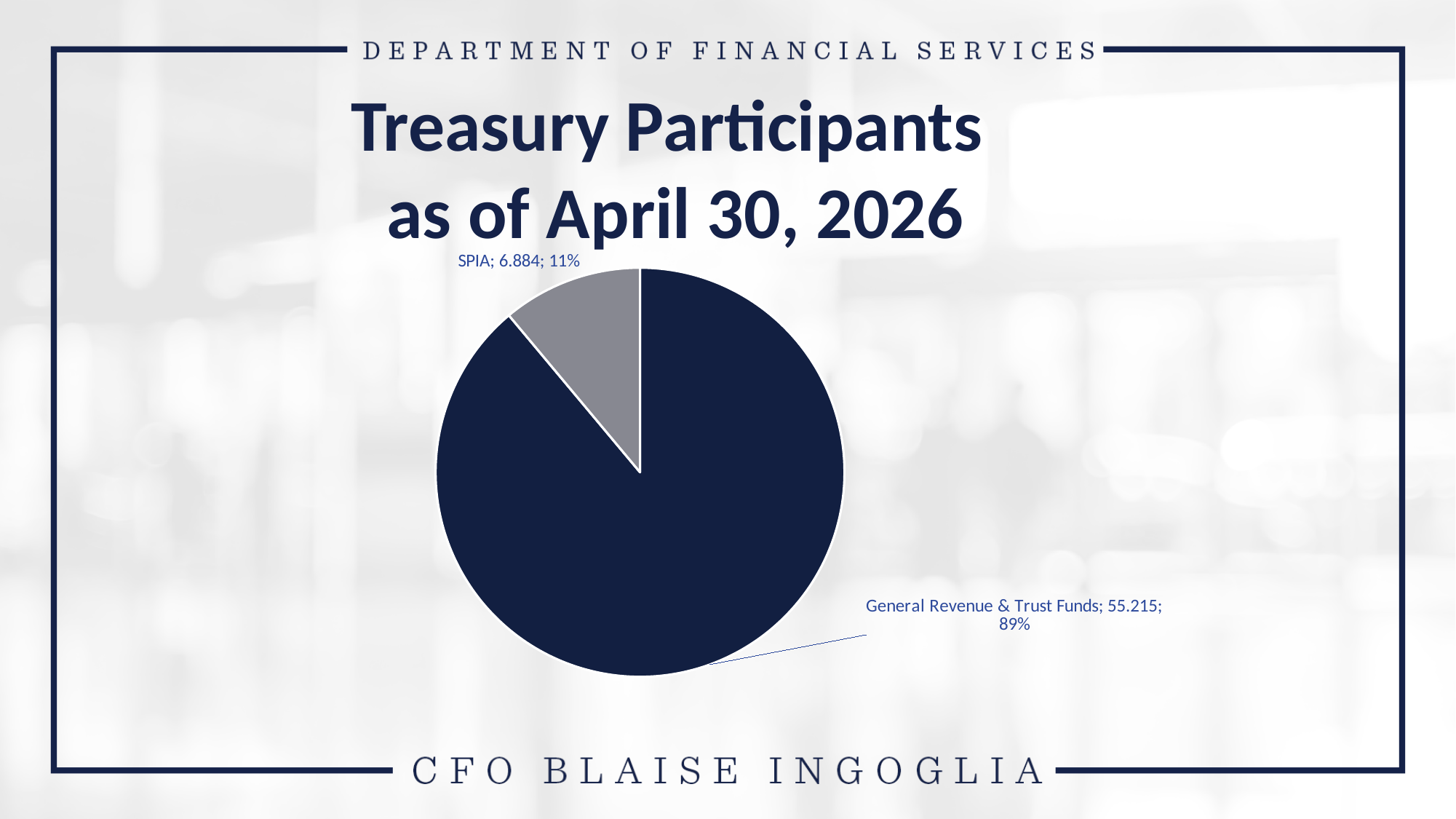
What share of the pie does General Revenue & Trust Funds represent? 89% What is the difference between the values for General Revenue & Trust Funds and SPIA? 48.331 What share of the pie does SPIA represent? 11% What is the title of the chart? Treasury Participants as of April 30, 2026 What is the value for SPIA? 6.884 What kind of chart is shown on the slide? Pie chart Which slice is the smallest? SPIA What is the value for General Revenue & Trust Funds? 55.215 What colour is the SPIA slice? Grey Which slice is the largest? General Revenue & Trust Funds Which is larger, SPIA or General Revenue & Trust Funds? General Revenue & Trust Funds How many slices does the pie chart have? 2